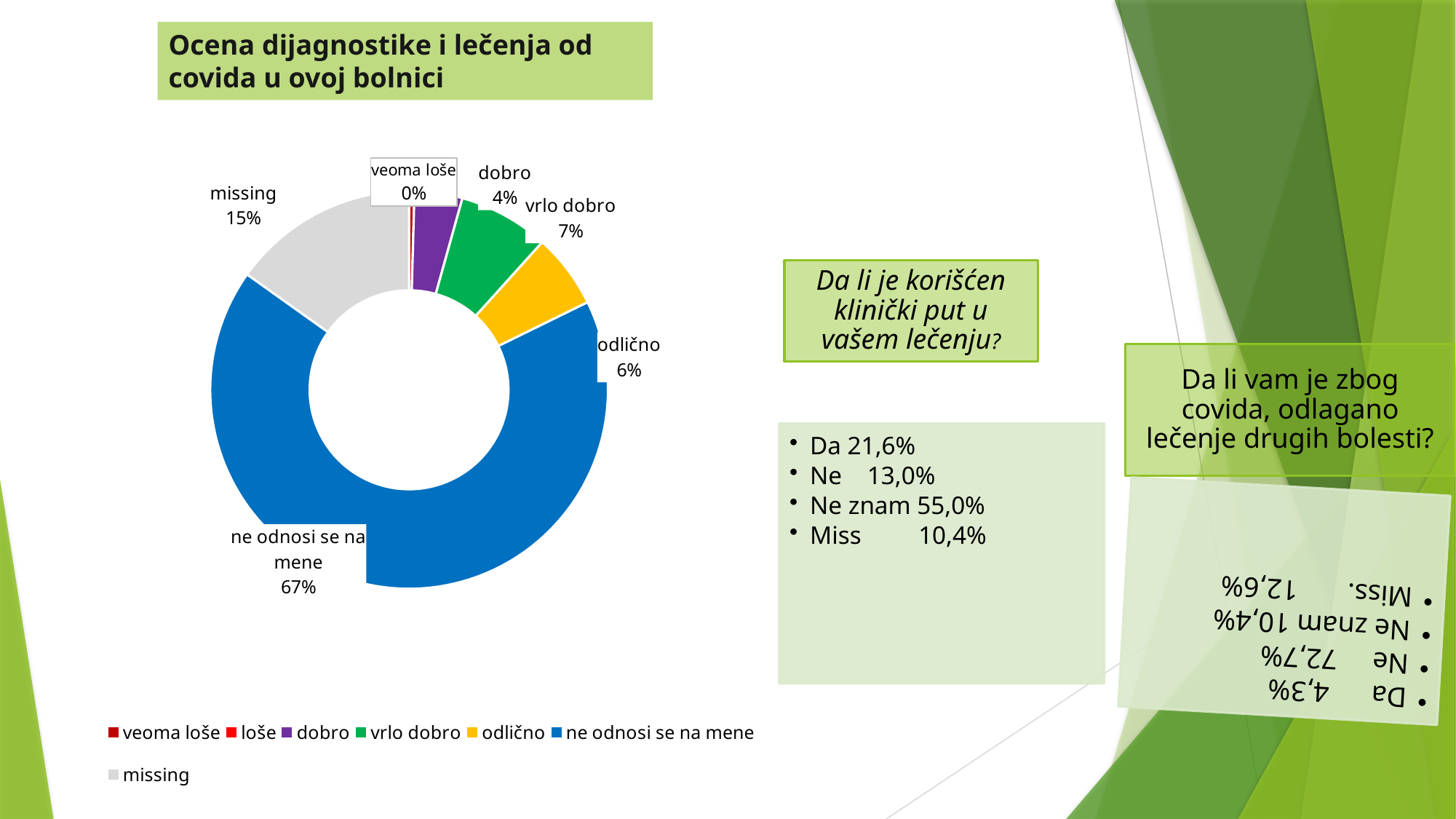
How many percentage points larger is 'missing' than 'vrlo dobro'? 8% What percentage does the 'ne odnosi se na mene' slice represent in the chart? 67% How many categories does the chart legend list? 7 What is the value shown for 'missing' in the chart? 15% What is the value for 'odlično' in the chart? 6% Which category has the largest share of the chart? ne odnosi se na mene What percentage is labelled for 'vrlo dobro'? 7% What type of chart is shown on the slide? doughnut chart Which is larger, the share for 'vrlo dobro' or for 'odlično'? vrlo dobro What percentage is shown for 'dobro'? 4% What is the difference between the 'ne odnosi se na mene' share and the 'missing' share? 52% What value is labelled for 'veoma loše'? 0%